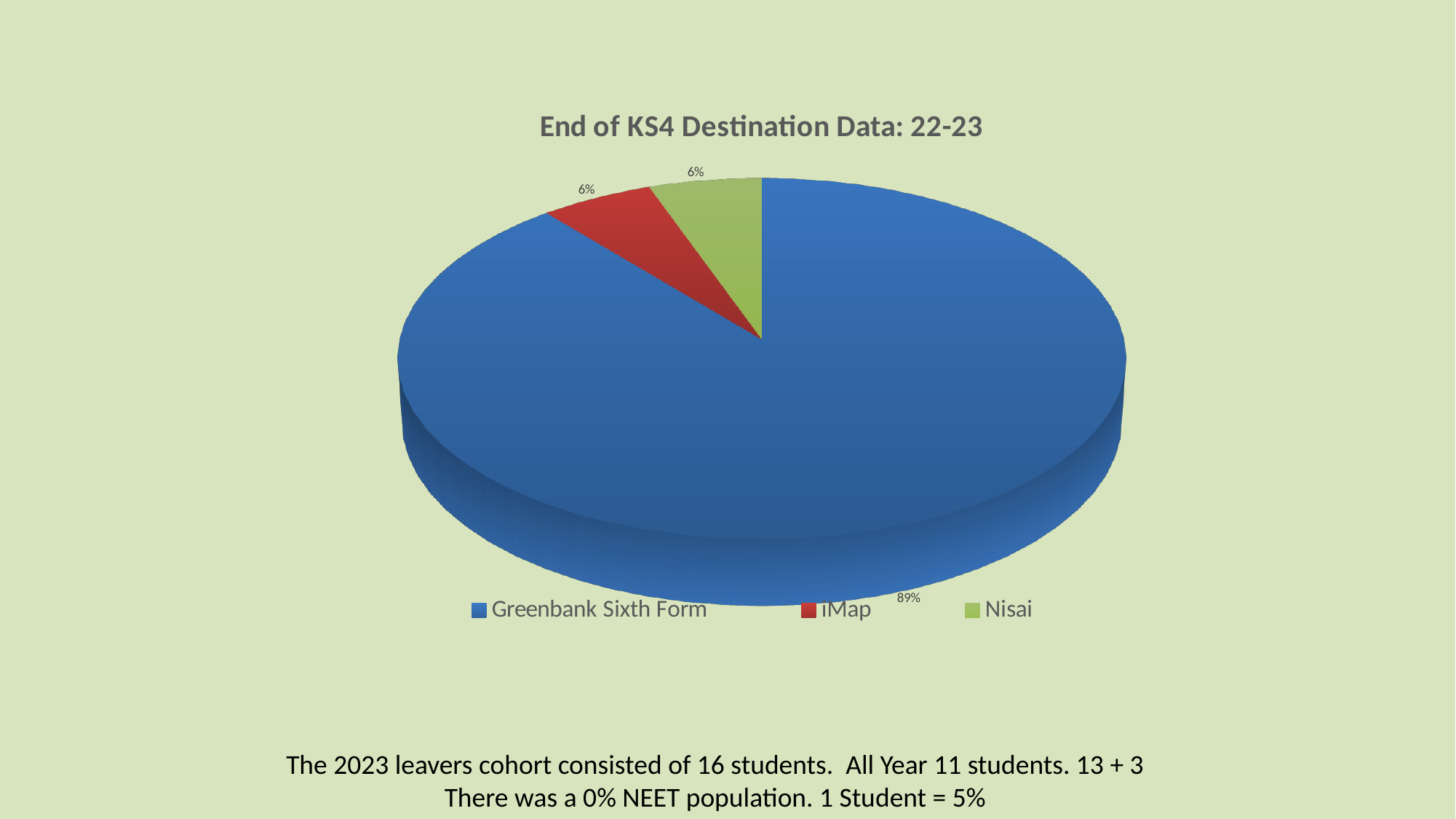
How many slices does the pie chart have? 3 What share of the pie is taken by Nisai? 6% What percentage of the pie does Greenbank Sixth Form account for? 89% What is the difference in percentage points between Greenbank Sixth Form and iMap? 83% How many entries does the legend list? 3 What percentage is shown for Nisai? 6% What kind of chart is shown on the slide? Pie chart What colour represents iMap in the chart? Red Which destination has the largest share of the pie? Greenbank Sixth Form Which is larger, the share for Greenbank Sixth Form or the share for Nisai? Greenbank Sixth Form What is the title of the chart? End of KS4 Destination Data: 22-23 What percentage is shown for iMap? 6%